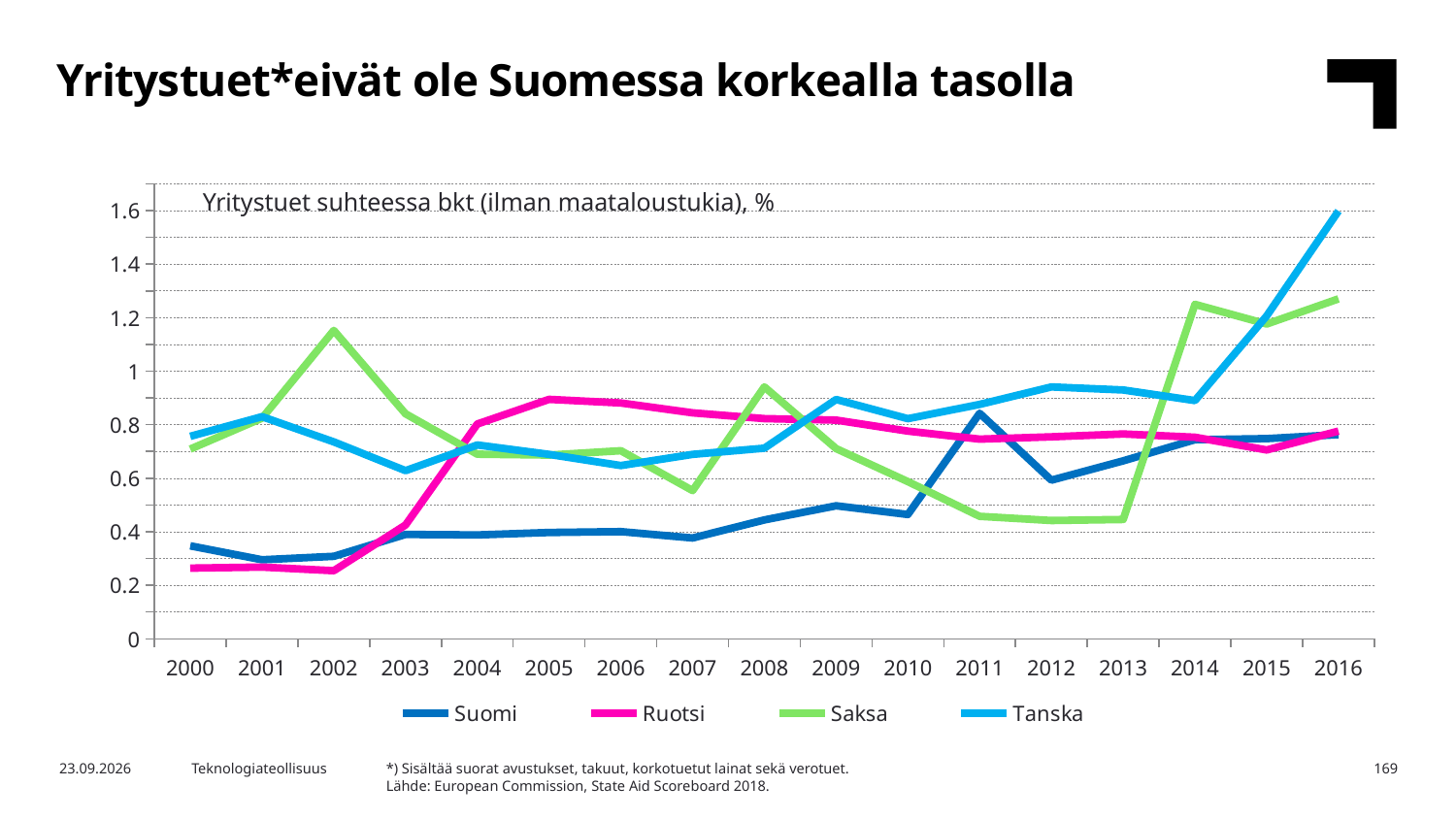
Is the value for Ruotsi in 2005 greater or less than 0.8? greater Which series has the highest value in 2016? Tanska Does the Tanska line rise or fall from 2013 to 2016? rise What kind of chart is shown on the slide? line chart What is the title of the chart? Yritystuet suhteessa bkt (ilman maataloustukia), % Is the value for Saksa in 2002 greater or less than 1? greater Which series has the lowest value in 2013? Saksa In 2002, which is larger: the value for Saksa or the value for Tanska? Saksa How many series does the legend list? 4 Is the value for Tanska in 2016 greater or less than 1.4? greater How many years are shown on the x axis? 17